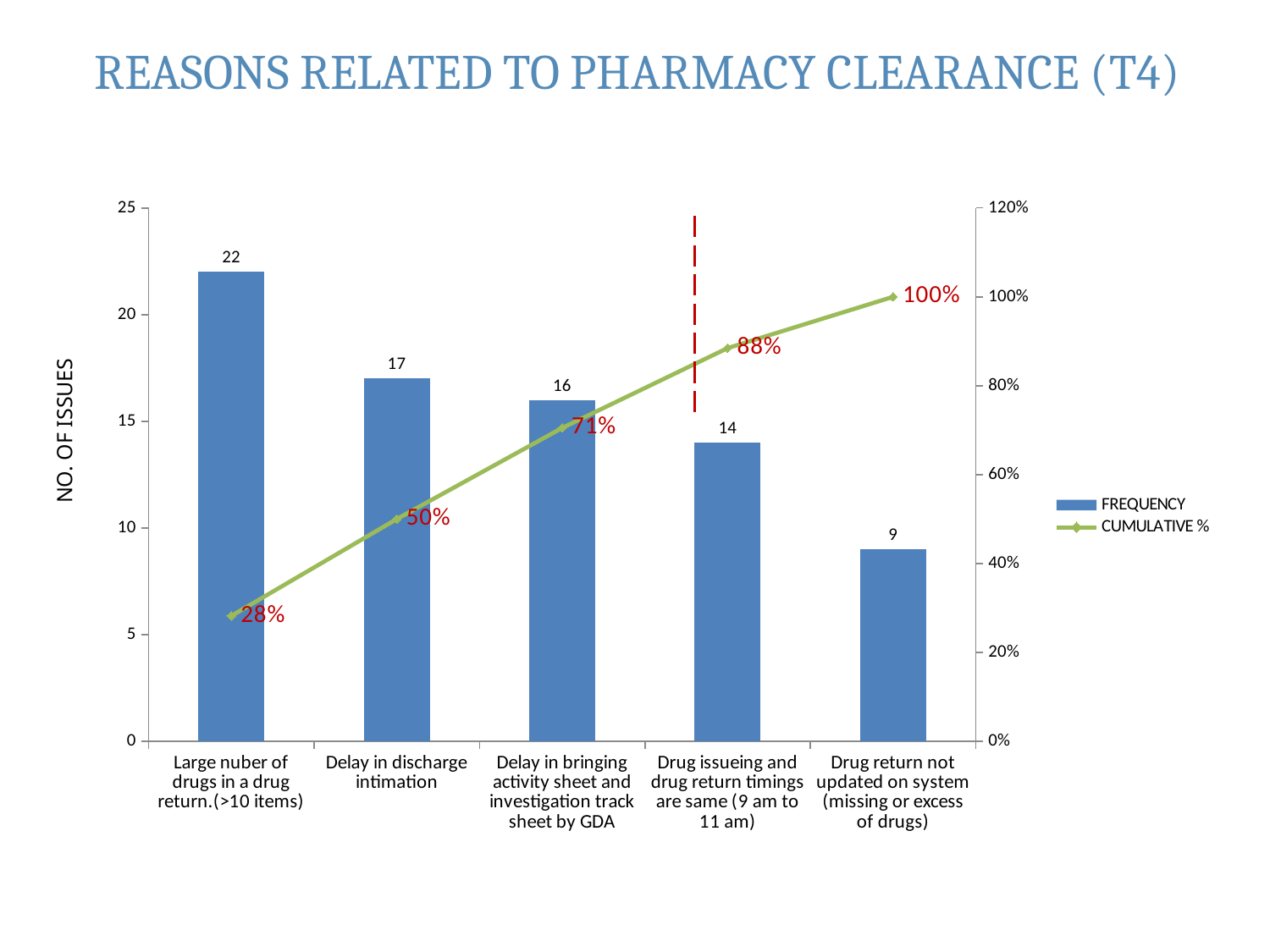
Does the cumulative % line rise or fall from left to right? Rise What is the title of the chart? REASONS RELATED TO PHARMACY CLEARANCE (T4) How many series does the legend list? 2 What is the frequency for 'Drug return not updated on system (missing or excess of drugs)'? 9 Which category has the lowest frequency? Drug return not updated on system (missing or excess of drugs) Which has a higher frequency: 'Delay in discharge intimation' or 'Drug issueing and drug return timings are same (9 am to 11 am)'? Delay in discharge intimation What kind of chart is this? Combined bar and line chart What is the frequency for 'Delay in discharge intimation'? 17 Which category has the highest frequency? Large nuber of drugs in a drug return.(>10 items) What is the cumulative % at 'Delay in bringing activity sheet and investigation track sheet by GDA'? 71% What is the difference in frequency between 'Large nuber of drugs in a drug return.(>10 items)' and 'Drug issueing and drug return timings are same (9 am to 11 am)'? 8 How many categories are shown on the x axis? 5